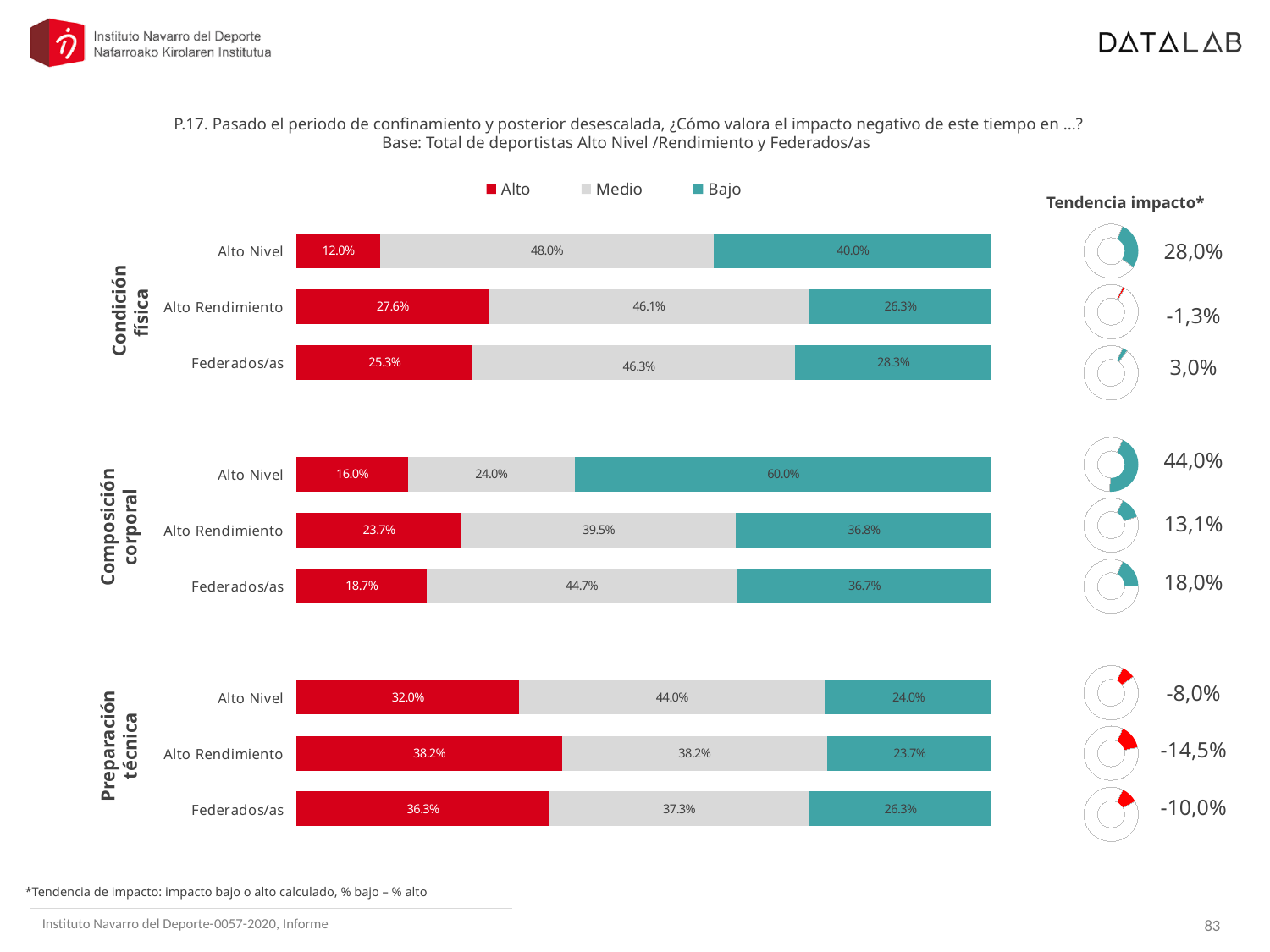
How many categories are shown in the Composición corporal chart? 3 In the Condición física chart, what is the Alto value for Alto Nivel? 12.0% In the Composición corporal chart, what is the Bajo value for Alto Nivel? 60.0% What is the Tendencia impacto value shown for Alto Nivel in Composición corporal? 44,0% Which colour represents the Alto series in the legend? Red In the Preparación técnica chart, what is the Medio value for Federados/as? 37.3% In the Condición física chart, which category has the lowest Alto value? Alto Nivel In the Condición física chart, which is larger: the Bajo value for Alto Nivel or the Bajo value for Federados/as? Alto Nivel How many series does the legend list? 3 What kind of chart is used for Preparación técnica? Stacked bar chart In the Preparación técnica chart, which category has the highest Alto value? Alto Rendimiento In the Composición corporal chart, what is the difference between the Bajo value for Alto Nivel and the Bajo value for Alto Rendimiento? 23.2%